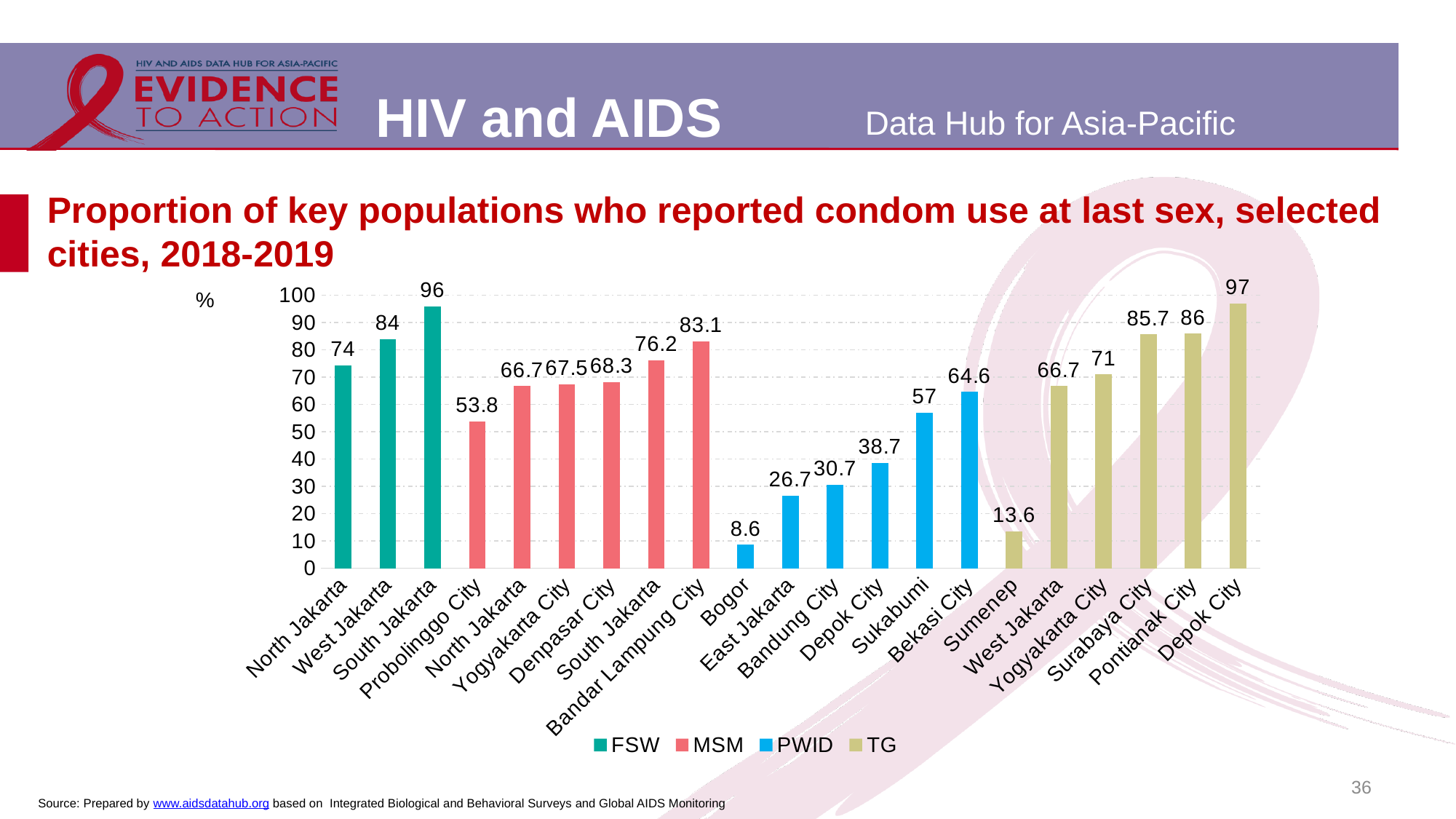
What is the value for South Jakarta in the FSW series? 96 What kind of chart is shown on the slide? Bar chart What is the value for Sumenep in the TG series? 13.6 Which bar has the highest value on the chart? Depok City (TG), 97 What is the value for Bandar Lampung City in the MSM series? 83.1 Which city has the highest value in the MSM series? Bandar Lampung City How many bars are plotted on the chart in total? 21 What is the difference between West Jakarta and North Jakarta in the FSW series? 10 Which bar has the lowest value on the chart? Bogor (PWID), 8.6 In the PWID series, which is larger: Sukabumi or Bekasi City? Bekasi City What is the value for Bogor in the PWID series? 8.6 How many series does the legend list? 4